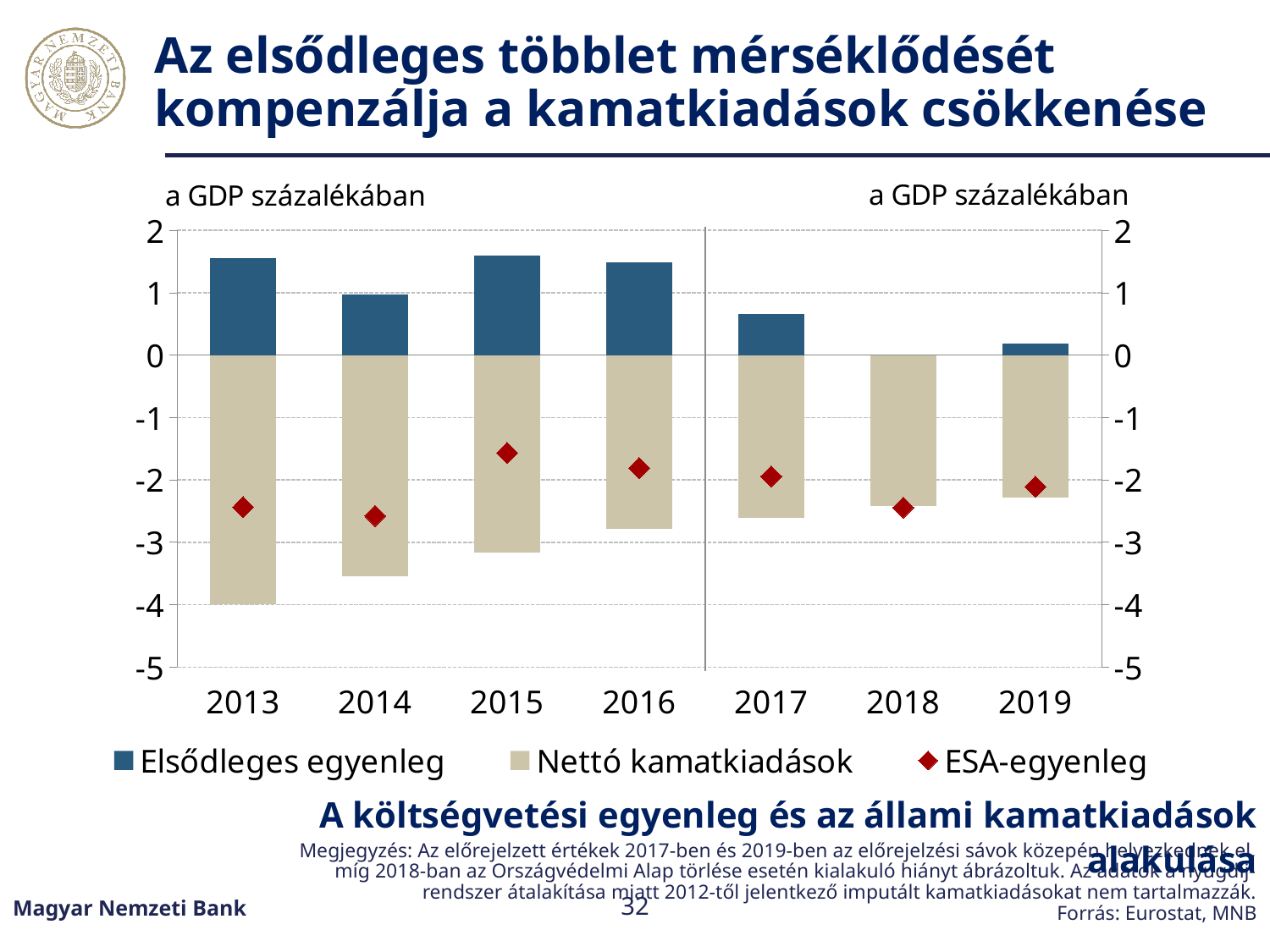
Which year has the lowest (most negative) value for Nettó kamatkiadások? 2013 Is the Nettó kamatkiadások value for 2013 greater or less than -3? less Which year has the highest ESA-egyenleg value? 2015 Is the Elsődleges egyenleg value for 2014 larger or smaller than the value for 2017? larger Is the Elsődleges egyenleg value for 2013 greater or less than 1? greater Which year has the lowest value for Elsődleges egyenleg? 2018 Is the ESA-egyenleg value for 2015 greater or less than -2? greater How many series does the chart legend list? 3 Do the Nettó kamatkiadások values rise or fall from 2013 to 2019? rise How many years are shown on the x axis of the chart? 7 What unit is given in the label above the chart's axes? a GDP százalékában What kind of chart is shown on the slide? bar chart